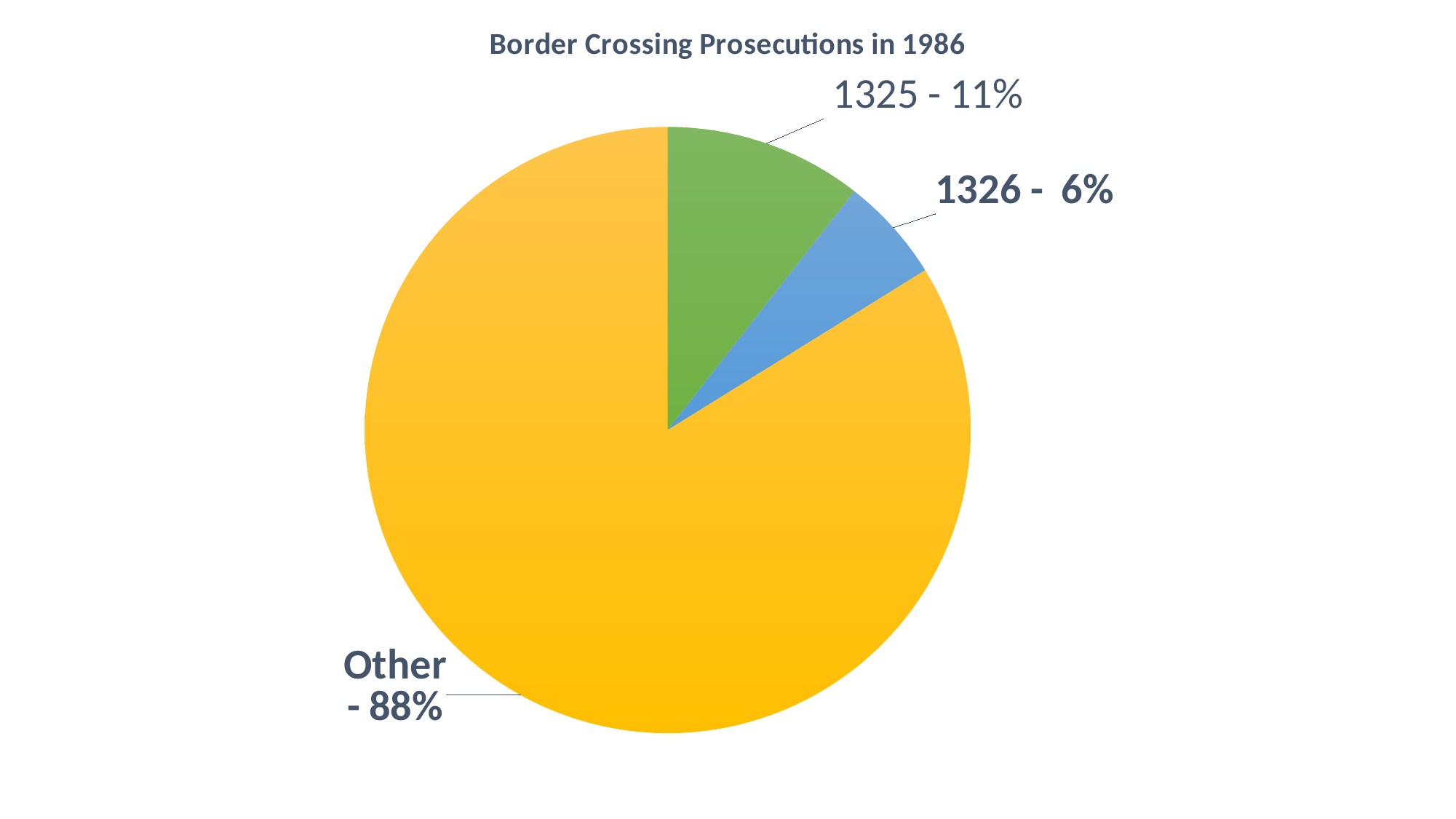
What colour is the Other slice? yellow Which slice is the smallest? 1326 What share of the pie does the 1326 slice represent? 6% What is the difference in percentage points between the 1325 slice and the 1326 slice? 5 Which slice is the largest? Other What is the title of the chart? Border Crossing Prosecutions in 1986 Which slice is larger, 1325 or 1326? 1325 What share of the pie does the 1325 slice represent? 11% What share of the pie does the Other slice represent? 88% What kind of chart is shown on the slide? pie chart What is the difference in percentage points between the Other slice and the 1325 slice? 77 How many slices does the pie chart have? 3